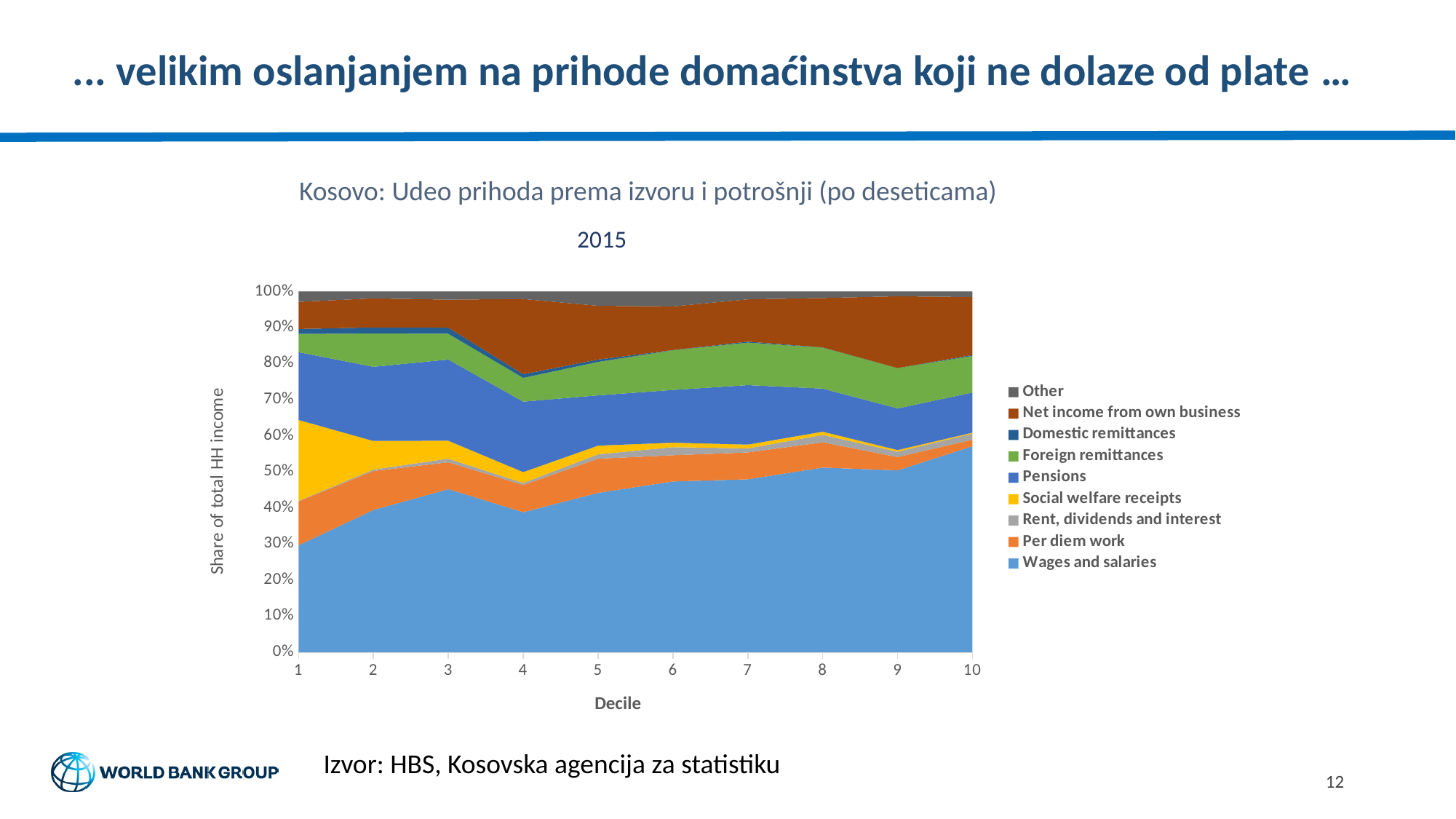
Is the share of Wages and salaries in decile 5 greater or less than 40%? greater Is the share of Wages and salaries in decile 1 greater or less than 40%? less Does the share of Wages and salaries generally rise or fall from decile 1 to decile 10? Rise How many series does the legend list? 9 Which year does the chart refer to? 2015 Is the share of Wages and salaries larger in decile 1 or in decile 10? Decile 10 What is the label of the y axis? Share of total HH income Is the share of Wages and salaries in decile 10 greater or less than 50%? greater What kind of chart is shown on the slide? Stacked area chart Which decile has the largest share of Social welfare receipts? 1 How many deciles are shown along the x axis? 10